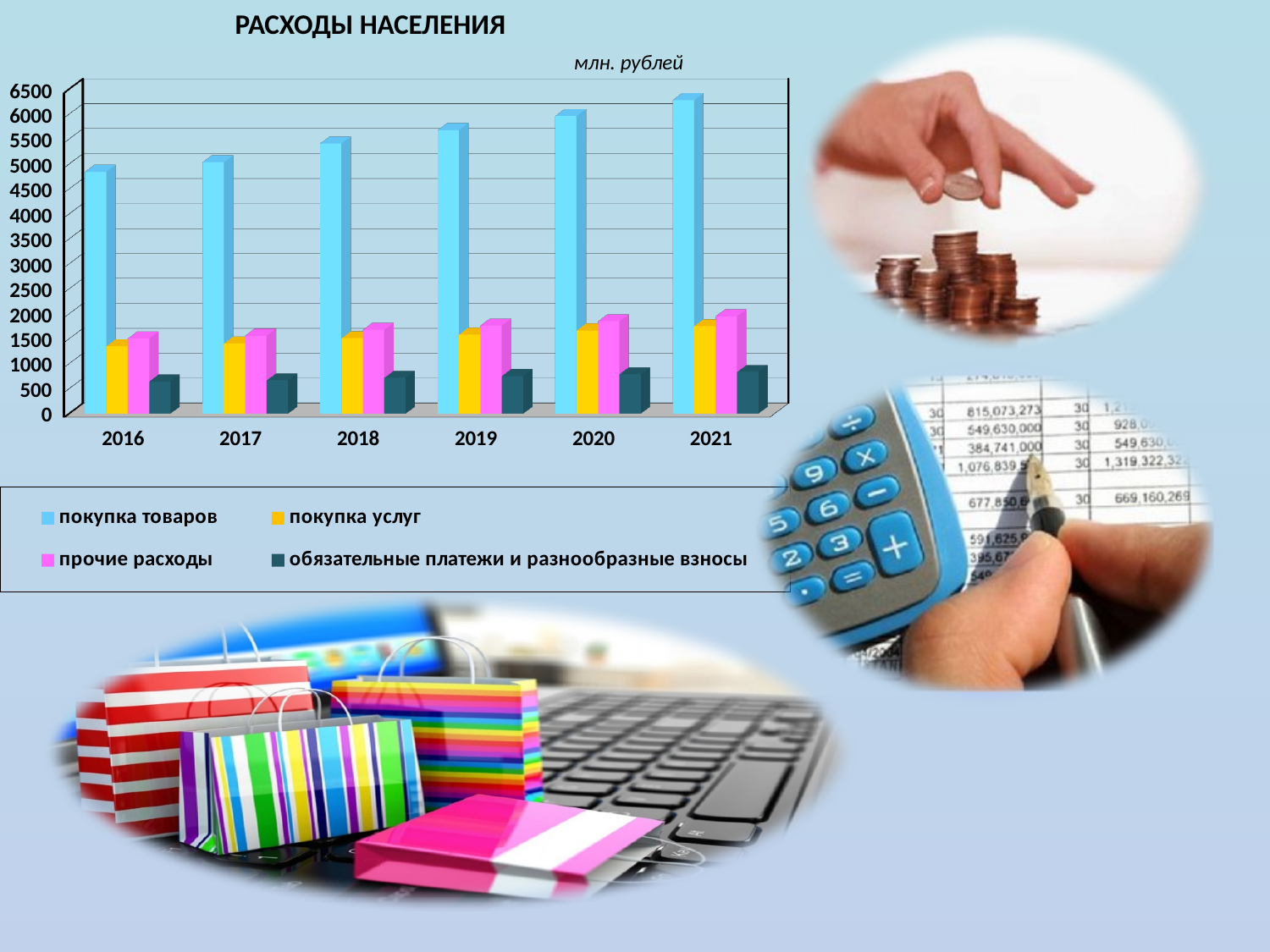
What kind of chart is shown on the slide? bar chart In what units are the values on the chart expressed? млн. рублей What is the title of the chart? РАСХОДЫ НАСЕЛЕНИЯ Is the value for обязательные платежи и разнообразные взносы in 2016 greater or less than 1000? less Is the value for прочие расходы in 2021 greater or less than 1500? greater In 2021, which is larger: покупка товаров or покупка услуг? покупка товаров Do the values for покупка товаров rise or fall from 2016 to 2021? rise How many series does the legend list? 4 In which year is the value for покупка товаров the highest? 2021 How many years are shown on the x axis? 6 In which year is the value for покупка товаров the lowest? 2016 Is the value for покупка товаров in 2021 greater or less than 5500? greater